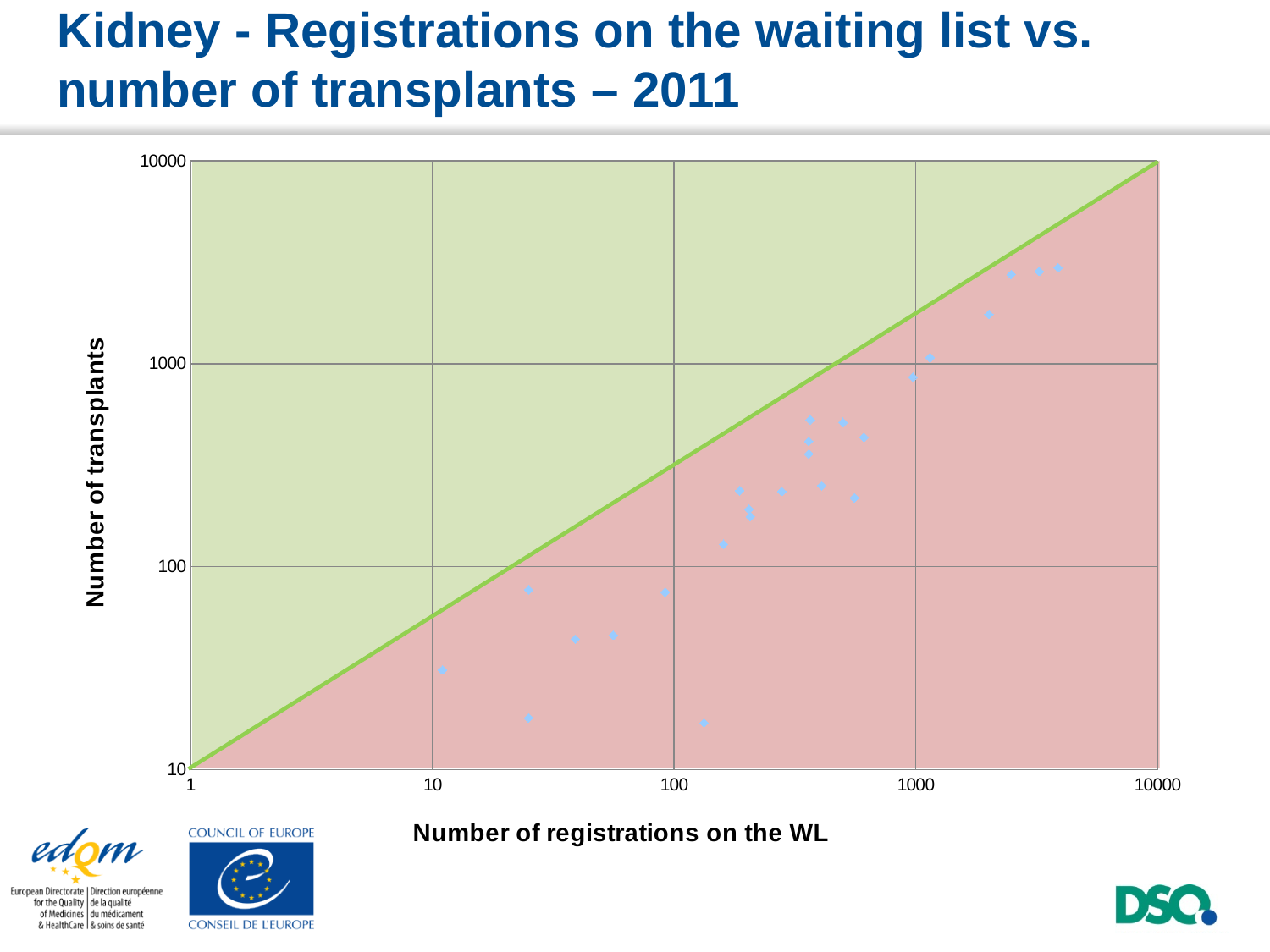
As the number of registrations on the waiting list increases along the x axis, do the plotted numbers of transplants generally rise or fall? rise What kind of chart is shown on the slide? scatter chart Is the largest plotted number of registrations on the WL greater or less than 1000? greater What is the title of the y axis? Number of transplants Is the lowest plotted number of transplants greater or less than 100? less Is the highest plotted number of transplants greater or less than 1000? greater What is the title of the x axis? Number of registrations on the WL